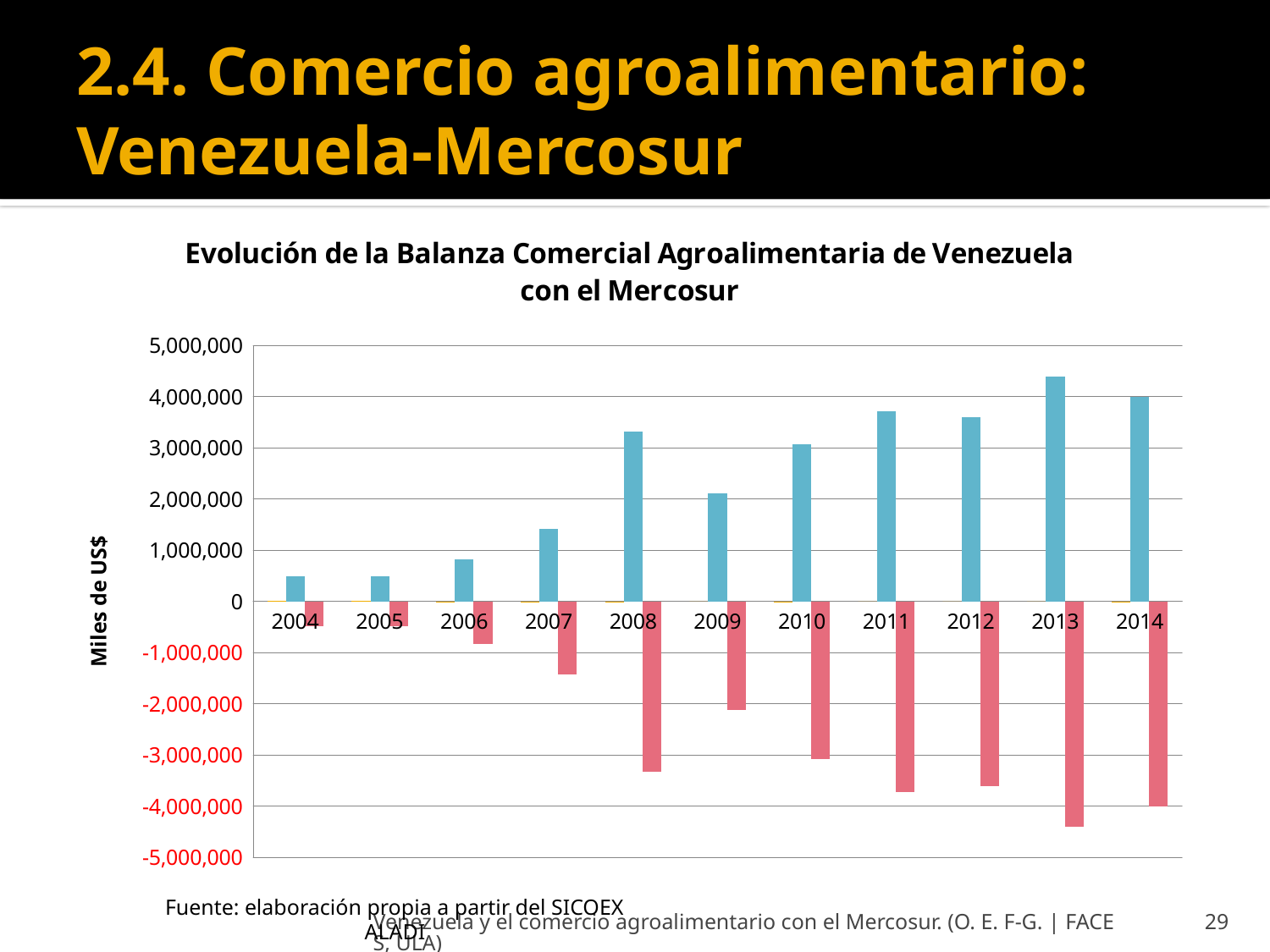
Is the value of the blue bar for 2008 greater or less than 3,000,000? greater What is the label on the vertical axis of the chart? Miles de US$ Which year has a larger blue bar, 2009 or 2010? 2010 Is the value of the red bar for 2008 greater or less than -3,000,000? less In which year does the red bar reach its lowest (most negative) value? 2013 How many years are shown on the x axis of the chart? 11 Is the value of the blue bar for 2006 greater or less than 1,000,000? less Do the blue bars generally rise or fall from 2004 to 2013? rise In which year is the blue bar the tallest? 2013 What is the title of the chart? Evolución de la Balanza Comercial Agroalimentaria de Venezuela con el Mercosur What kind of chart is shown on the slide? bar chart